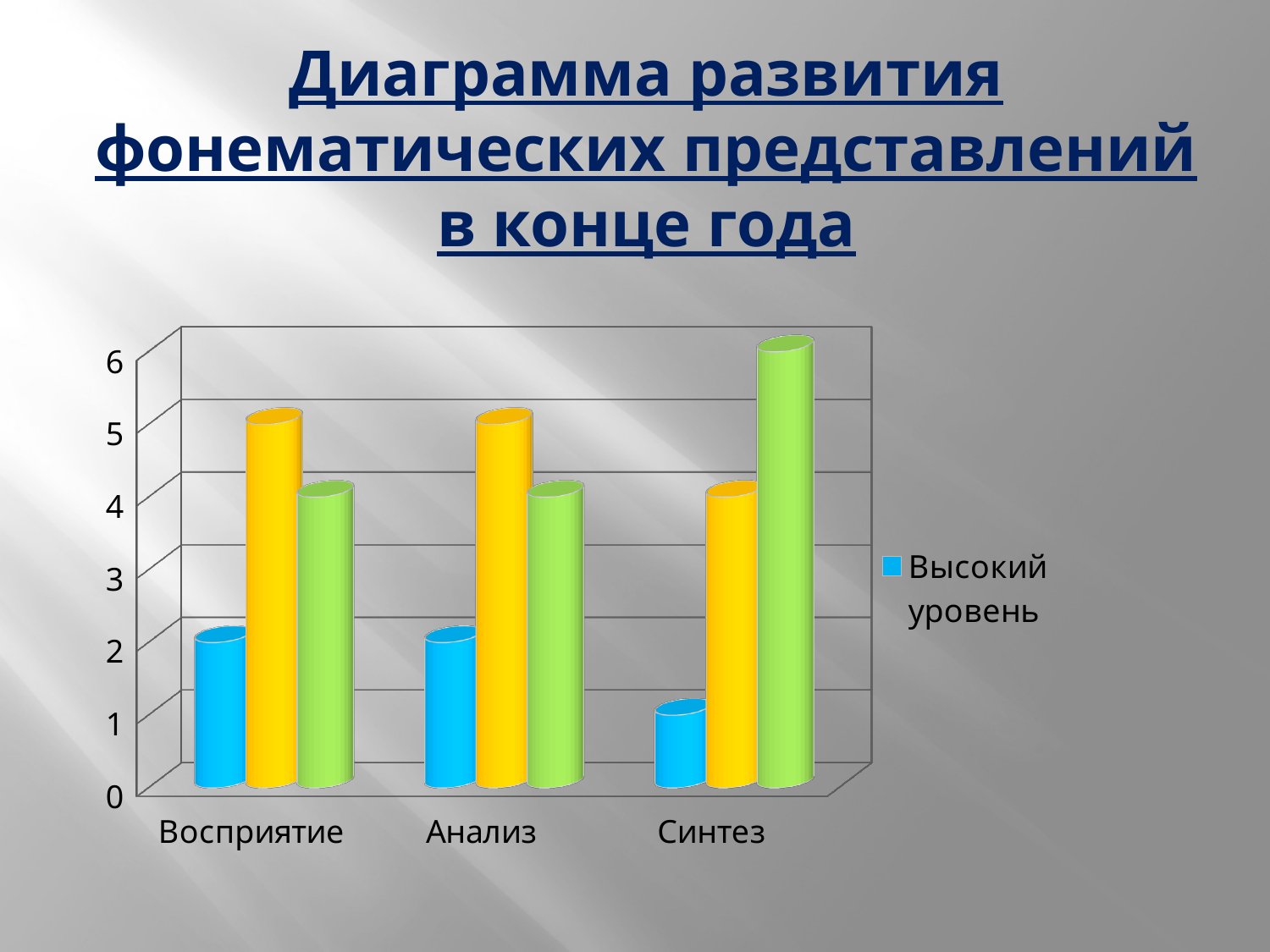
In the Высокий уровень series, which is larger: Восприятие or Синтез? Восприятие Is the value for Синтез in the Высокий уровень series greater or less than 2? less What is the title of the slide containing the chart? Диаграмма развития фонематических представлений в конце года Which series is named in the chart's legend? Высокий уровень How many series does the chart's legend list? 1 How many categories are shown on the x axis of the chart? 3 Is the value for Восприятие in the Высокий уровень series greater or less than 1? greater Which category has the lowest value in the Высокий уровень series? Синтез What is the highest value shown on the chart's vertical axis? 6 In the Высокий уровень series, which is larger: Анализ or Синтез? Анализ Is the value for Анализ in the Высокий уровень series greater or less than 3? less What kind of chart is shown on the slide? bar chart